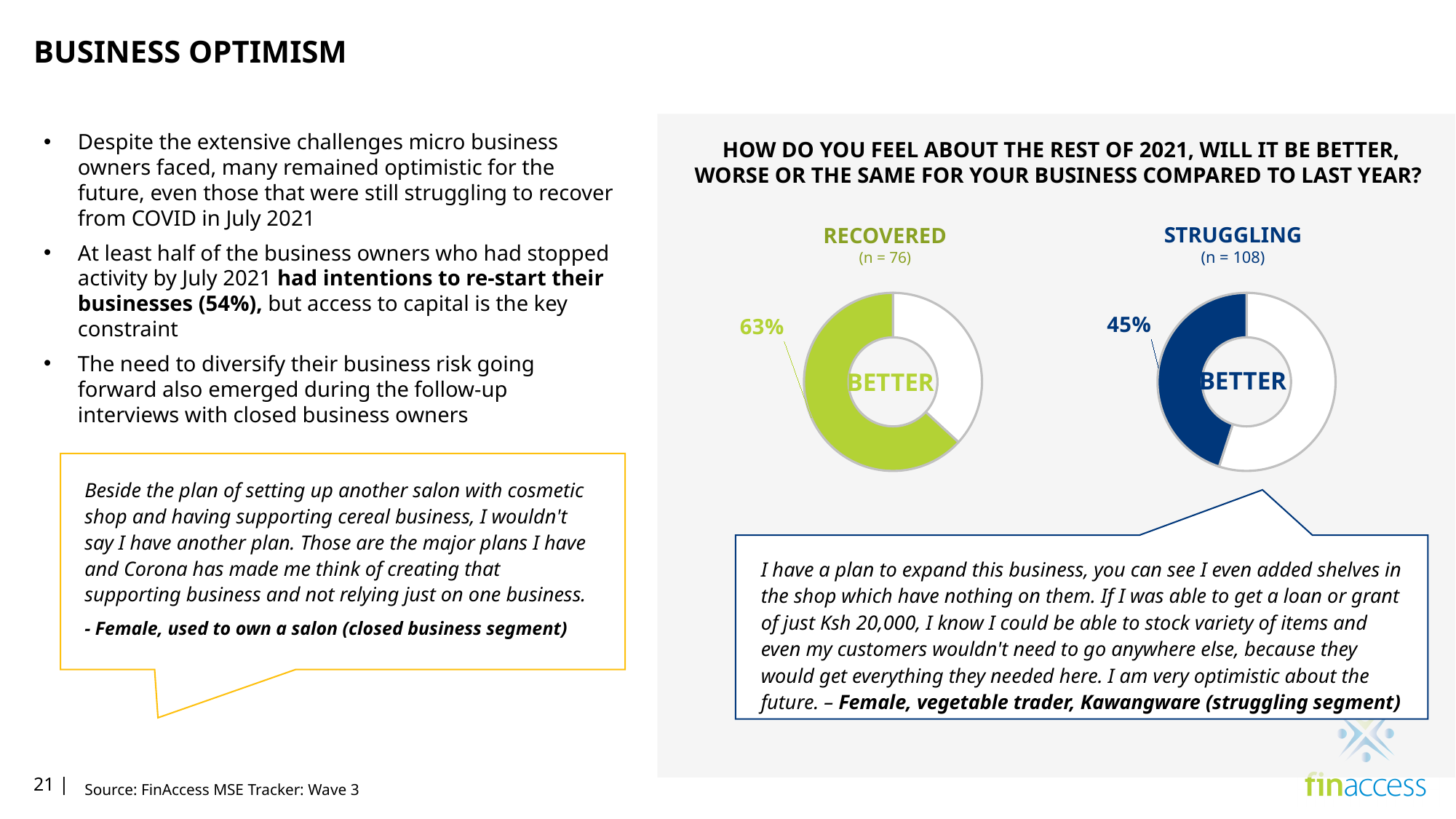
In the RECOVERED donut chart, what share of the pie is not labelled BETTER? 37% In the RECOVERED donut chart, what share of respondents said the rest of 2021 will be BETTER? 63% What is the sample size (n) shown for the STRUGGLING group? n = 108 What is the difference in percentage points between the BETTER share for RECOVERED and for STRUGGLING? 18 percentage points What is the sample size (n) shown for the RECOVERED group? n = 76 In the STRUGGLING donut chart, what share of the pie is not labelled BETTER? 55% How many donut charts are shown on the slide? 2 In the STRUGGLING donut chart, is the BETTER share greater or less than 50%? less In the RECOVERED donut chart, is the BETTER share greater or less than 50%? greater What kind of chart is used to show the BETTER share for the RECOVERED group? Donut (pie) chart In the STRUGGLING donut chart, what share of respondents said the rest of 2021 will be BETTER? 45% Which group has the larger share answering BETTER, RECOVERED or STRUGGLING? RECOVERED